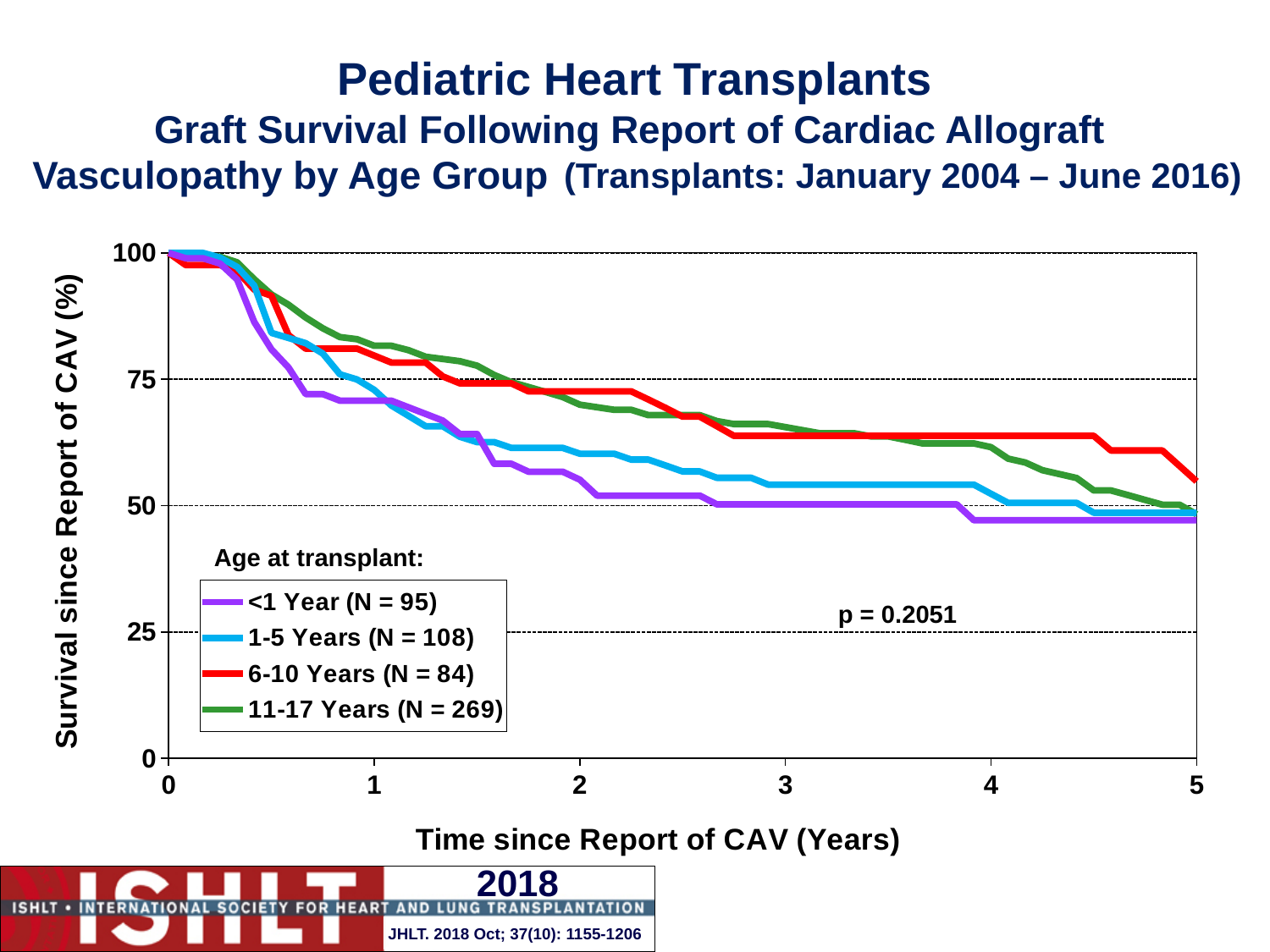
What is the N for the 1-5 Years age group in the legend? 108 What p-value is shown on the chart? p = 0.2051 Is the survival for the 11-17 Years group at 1 year since report of CAV greater or less than 75? greater Which age group has the smallest N in the legend? 6-10 Years What kind of chart is shown on the slide? Line chart How many age groups (series) does the legend list? 4 Which age group has the largest N in the legend? 11-17 Years At 5 years since report of CAV, which group has higher survival: 6-10 Years or <1 Year? 6-10 Years Is the survival for the 6-10 Years group at 3 years since report of CAV greater or less than 50? greater Is the survival for the <1 Year group at 5 years since report of CAV greater or less than 50? less Do the survival curves rise or fall as time since report of CAV increases? Fall What is the N for the 11-17 Years age group in the legend? 269